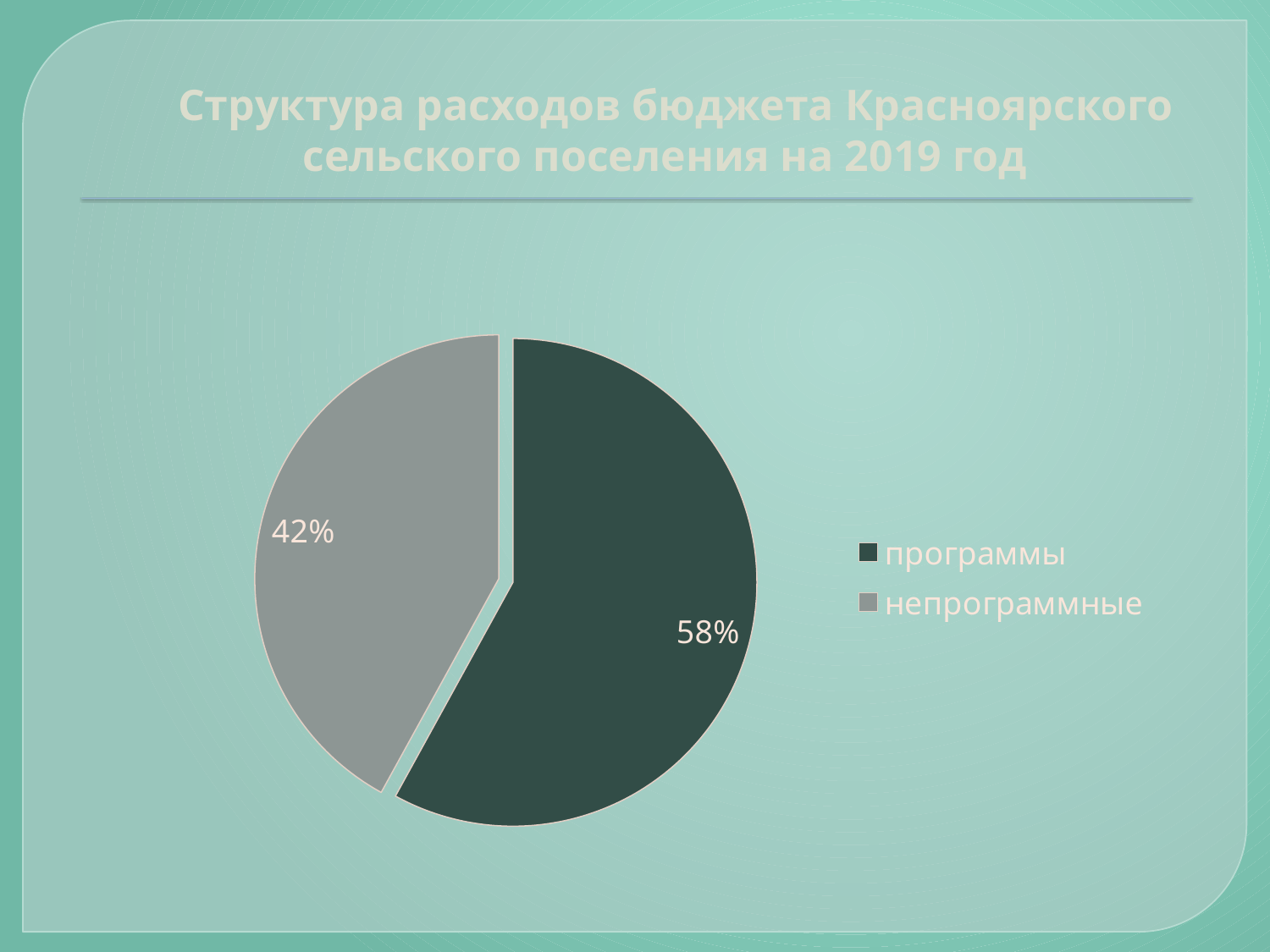
Is the share for "непрограммные" greater or less than 50%? less What is the difference in percentage points between the "программы" and "непрограммные" slices? 16% What share of the pie does the "программы" slice represent? 58% Is the share for "программы" greater or less than 50%? greater What share of the pie does the "непрограммные" slice represent? 42% Which category is shown in the lighter grey colour in the legend? непрограммные Which category has the smallest slice of the pie? непрограммные Which category has the largest slice of the pie? программы What kind of chart is shown on the slide? pie chart Which slice is larger, "программы" or "непрограммные"? программы How many slices does the pie chart have? 2 What is the title of the slide? Структура расходов бюджета Красноярского сельского поселения на 2019 год